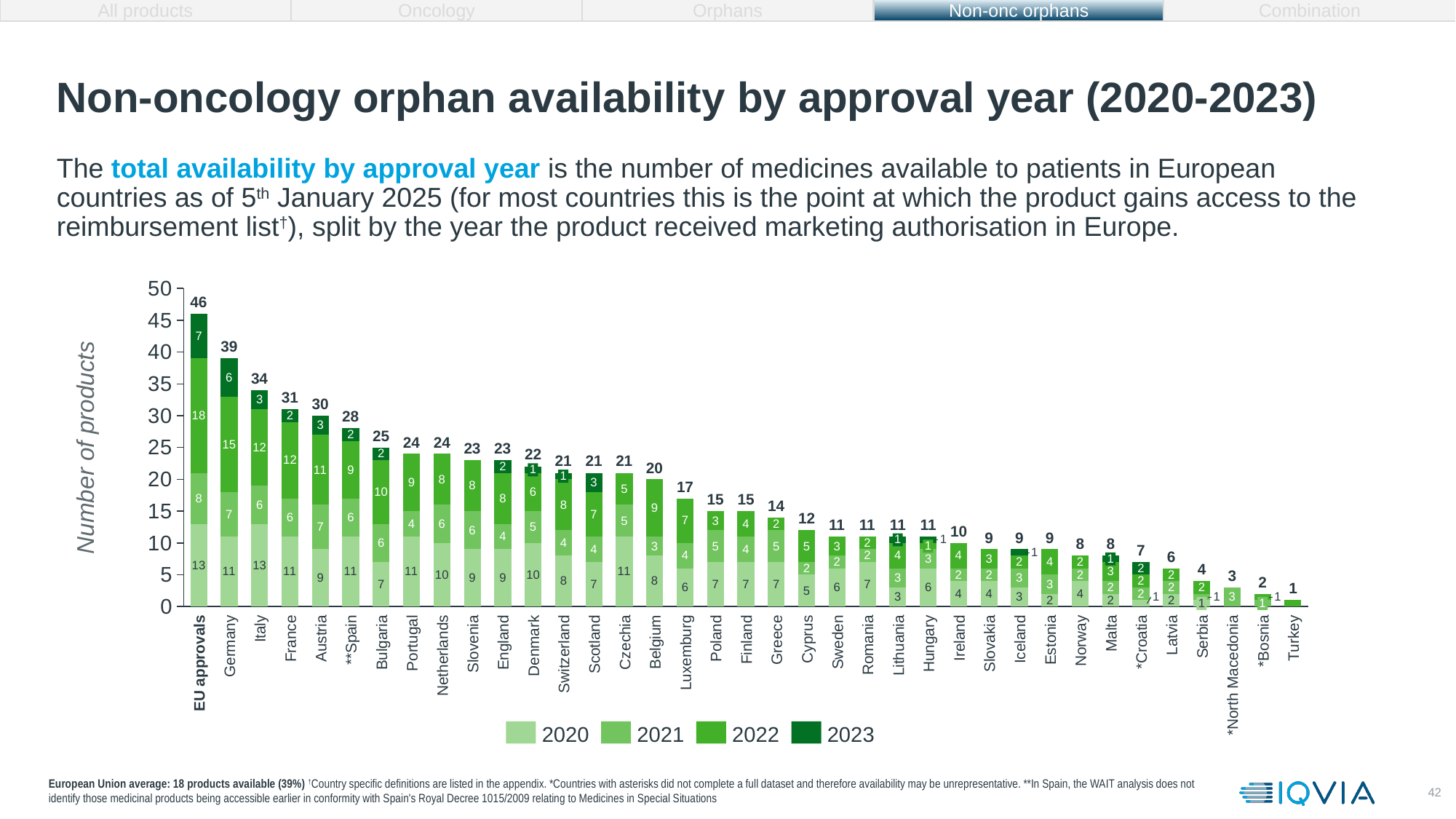
How many series does the legend list? 4 How many categories are shown on the x axis? 37 What kind of chart is shown on the slide? Stacked bar chart How many products from the 2020 approval year are shown for Italy? 13 What is the difference between the totals for Germany and Italy? 5 Do the bar totals rise or fall moving from left to right along the x axis? Fall What is the total number of products for Germany? 39 Which has a higher total, Luxemburg or Poland? Luxemburg Which country has the lowest total number of products? Turkey Which category has the highest total number of products? EU approvals How many products from the 2022 approval year are shown for EU approvals? 18 What is the total number of products for Belgium? 20